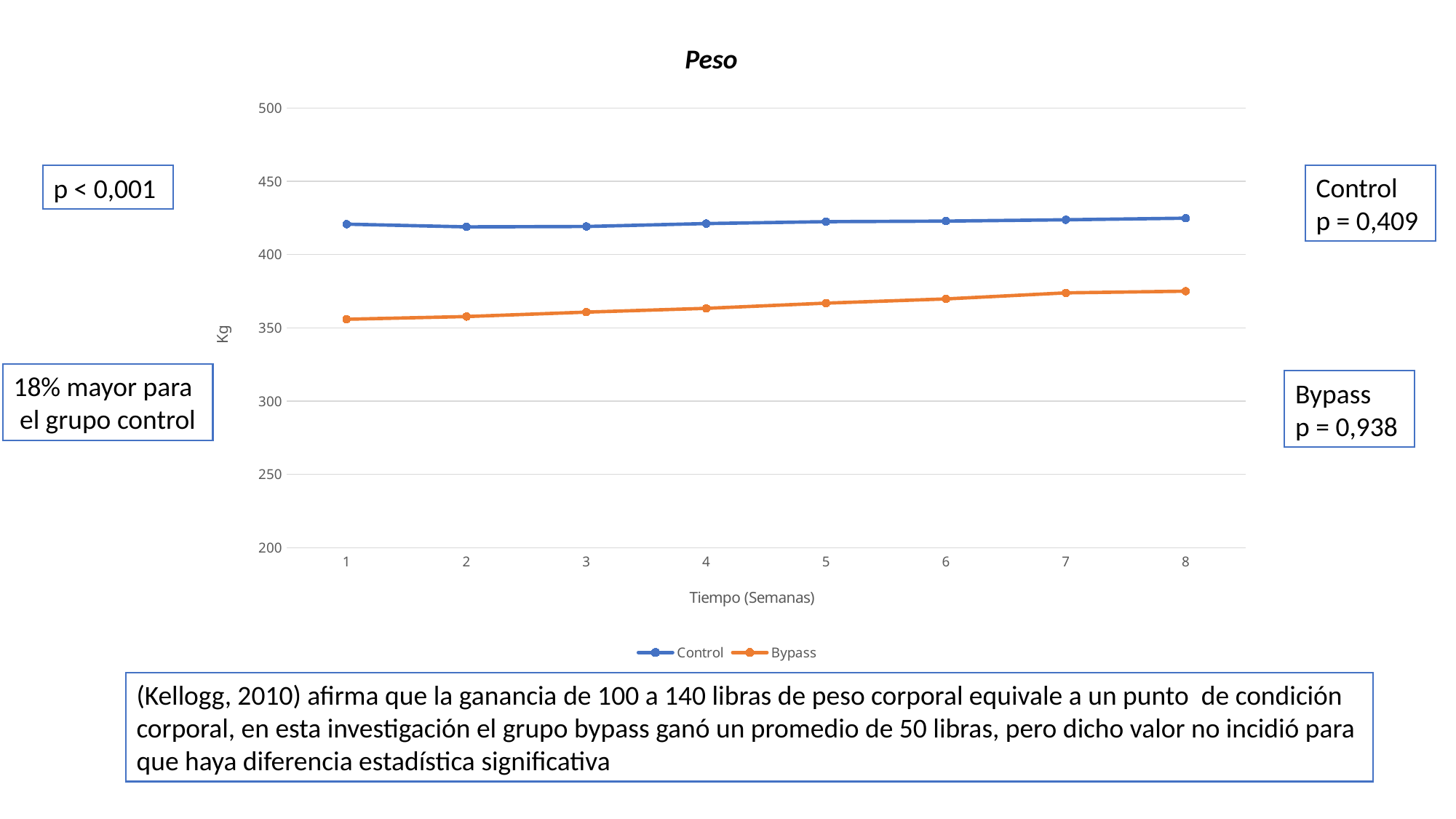
What is the label of the x axis? Tiempo (Semanas) What is the title of the chart? Peso What kind of chart is shown on the slide? line chart Is the value for Bypass at week 8 greater or less than 350? greater Is the value for Bypass at week 1 greater or less than 400? less Does the Bypass series rise or fall from week 1 to week 8? rise Is the value for Control at week 8 greater or less than 450? less How many series does the legend list? 2 Which series has the higher weight at week 1, Control or Bypass? Control Which series has the lower weight at week 8, Control or Bypass? Bypass How many time points (weeks) are plotted on the x axis? 8